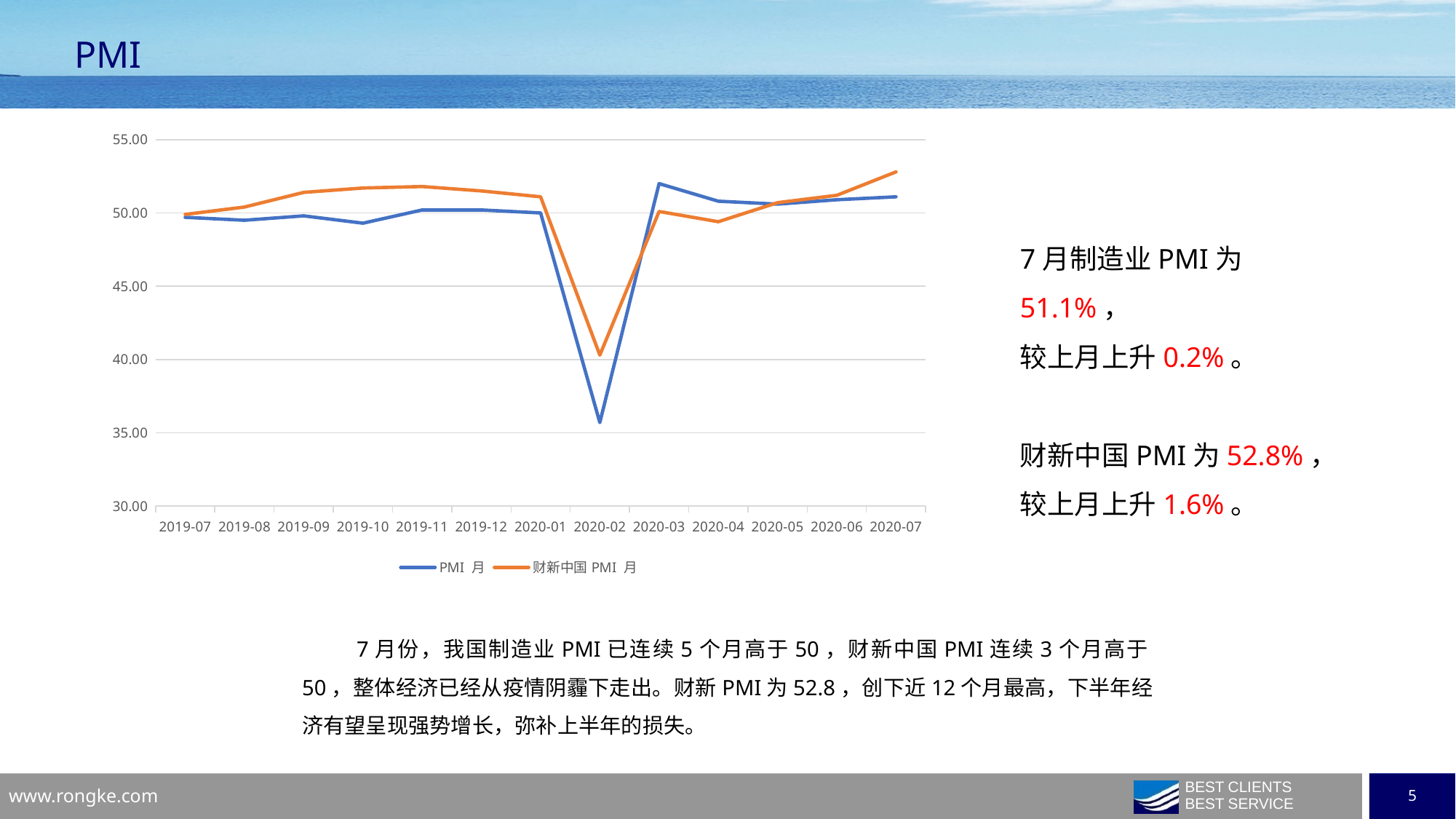
How many months are plotted along the x axis of the chart? 13 How many series does the chart legend list? 2 In which month does the PMI 月 series reach its lowest value? 2020-02 Is the value of PMI 月 in 2020-02 greater or less than 40? less Do the values of both series rise or fall from 2020-02 to 2020-03? rise Is the value of 财新中国 PMI 月 in 2020-02 greater or less than 45? less In 2020-02, which series has the higher value, PMI 月 or 财新中国 PMI 月? 财新中国 PMI 月 In 2020-03, which series has the higher value, PMI 月 or 财新中国 PMI 月? PMI 月 Is the value of PMI 月 in 2020-03 greater or less than 50? greater What kind of chart is shown on the slide? line chart In which month does the 财新中国 PMI 月 series reach its lowest value? 2020-02 In which month does the 财新中国 PMI 月 series reach its highest value? 2020-07